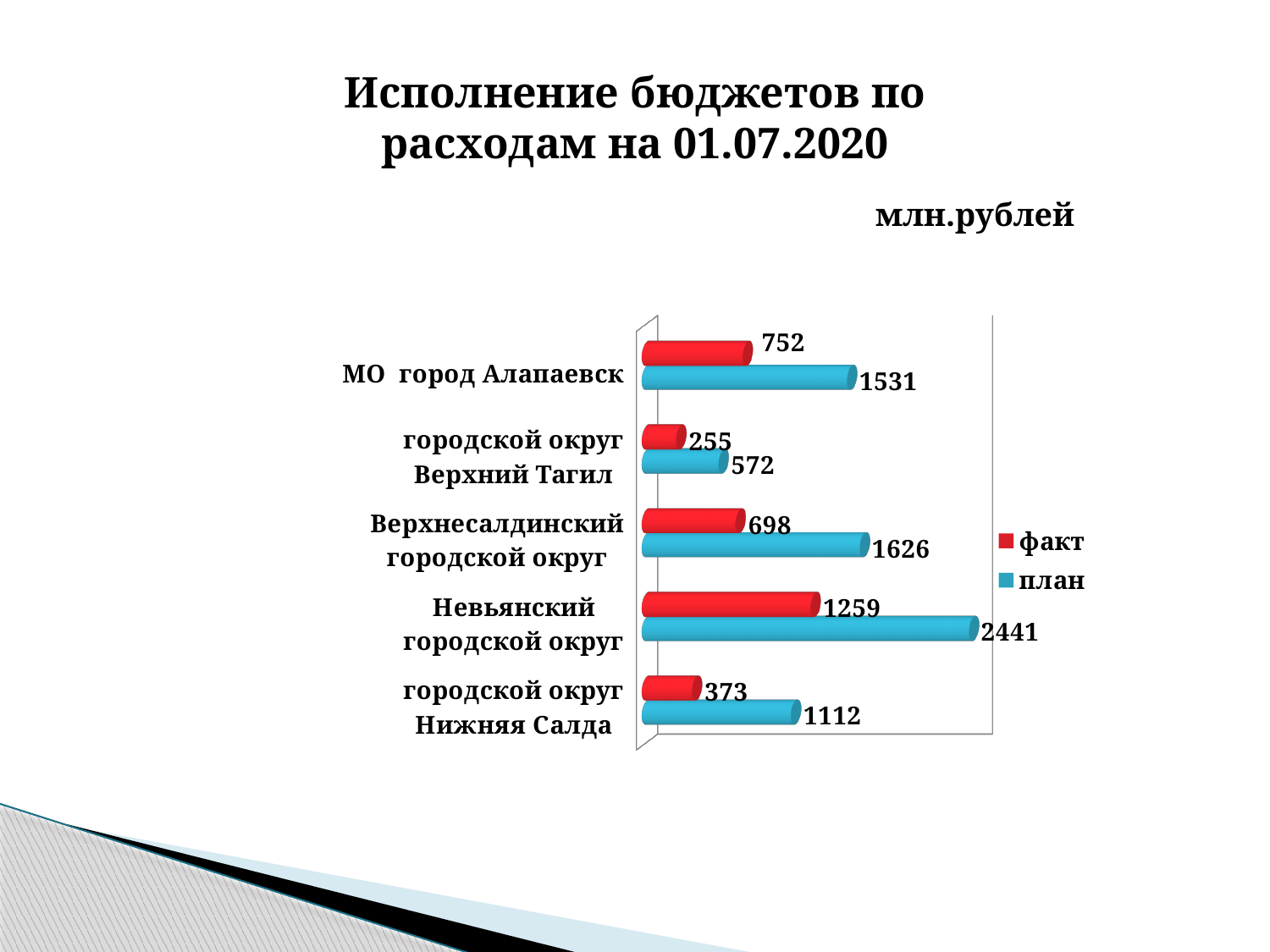
How many series does the legend list? 2 Which category has the lowest 'план' value? городской округ Верхний Тагил Which colour represents the 'план' series? Blue What is the difference between the 'план' and 'факт' values for Верхнесалдинский городской округ? 928 What is the 'факт' value for МО город Алапаевск? 752 What kind of chart is shown on the slide? Bar chart What is the difference between the 'план' and 'факт' values for городской округ Нижняя Салда? 739 Which category has the highest 'факт' value? Невьянский городской округ How many categories are shown on the chart? 5 Which is larger: the 'факт' value for МО город Алапаевск or the 'факт' value for Верхнесалдинский городской округ? МО город Алапаевск What is the 'план' value for городской округ Верхний Тагил? 572 What is the 'план' value for Невьянский городской округ? 2441